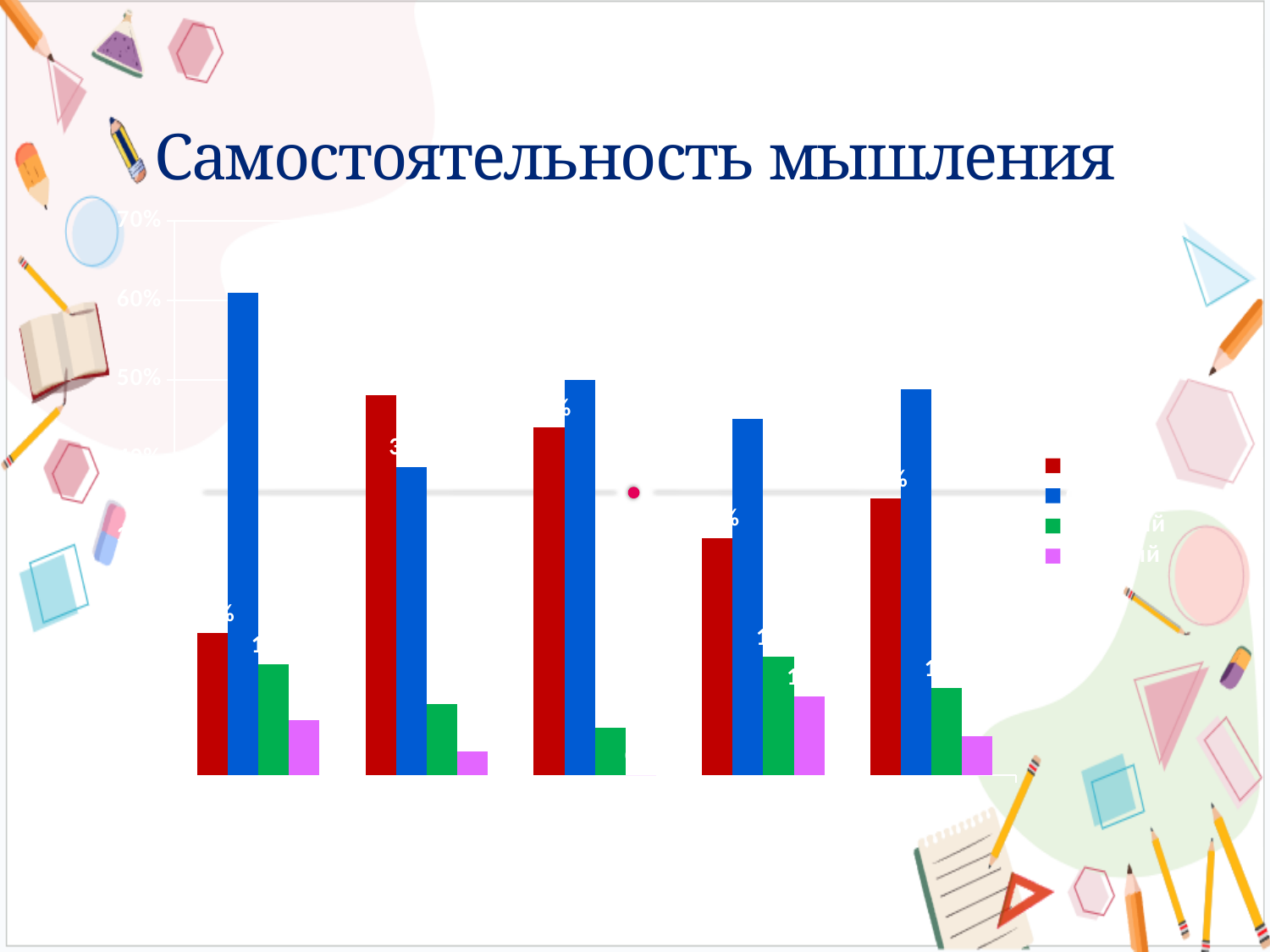
What colour is the tallest bar on the chart? blue In the leftmost group, which is larger, the red bar or the blue bar? the blue bar What kind of chart is shown on the slide? bar chart Is the value of the red bar in the leftmost group greater or less than 50%? less How many series does the legend list? 4 In the second group from the left, which is larger, the red bar or the blue bar? the red bar What is the title of the chart? Самостоятельность мышления How many groups of bars are plotted along the x axis? 5 Is the value of the blue bar in the leftmost group greater or less than 50%? greater